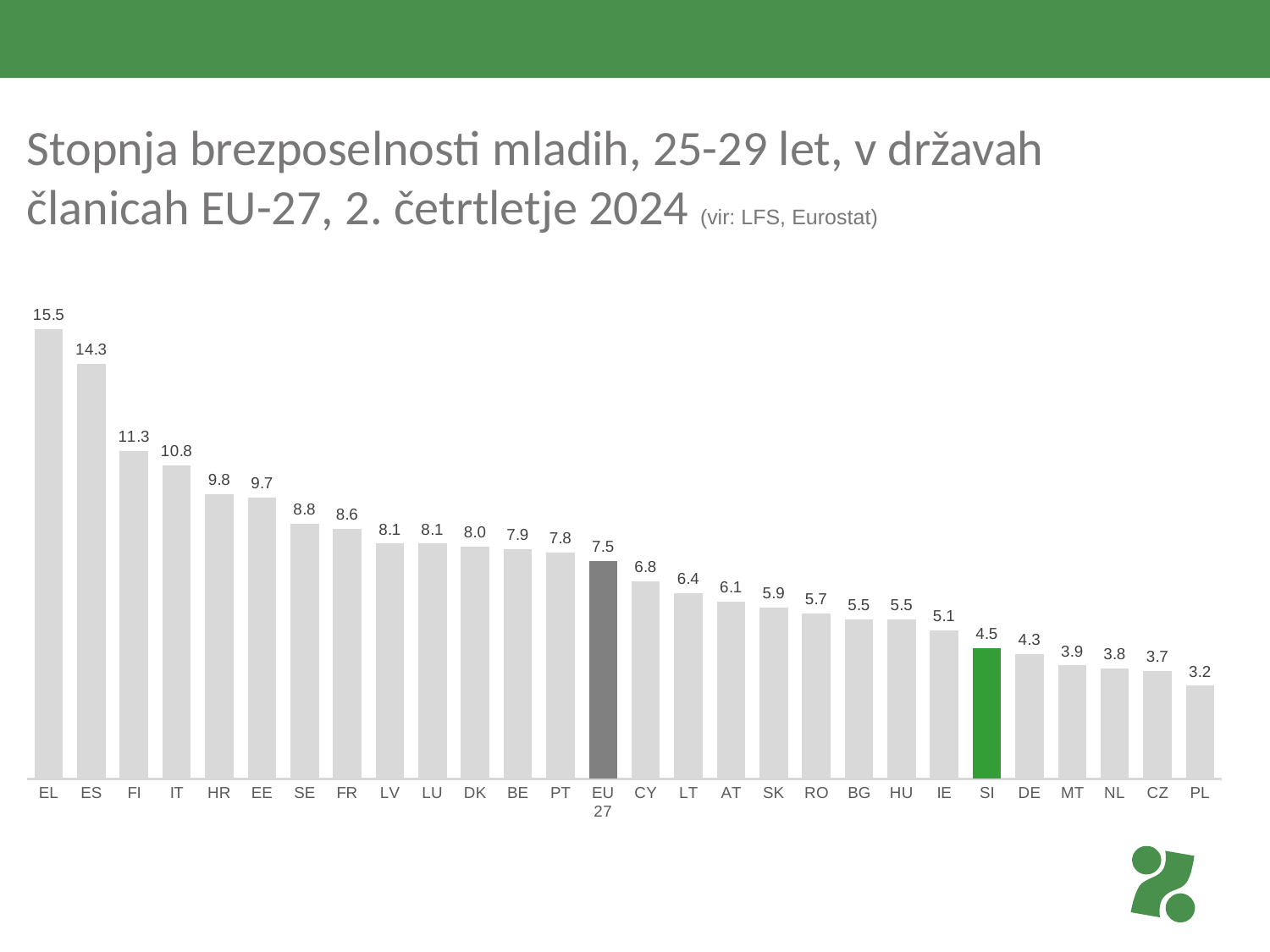
What is the value for HR? 9.8 How many bars are shown in the chart? 28 What is the value for EU 27? 7.5 What is the difference between the EU 27 value and the SI value? 3.0 Which country has the highest value? EL Which bar is coloured green? SI What kind of chart is shown on the slide? bar chart Which is larger, the value for CY or the value for LT? CY Which country has the lowest value? PL What is the difference between the values for EL and ES? 1.2 Do the values rise or fall from left to right along the x axis? fall What is the value for SI? 4.5